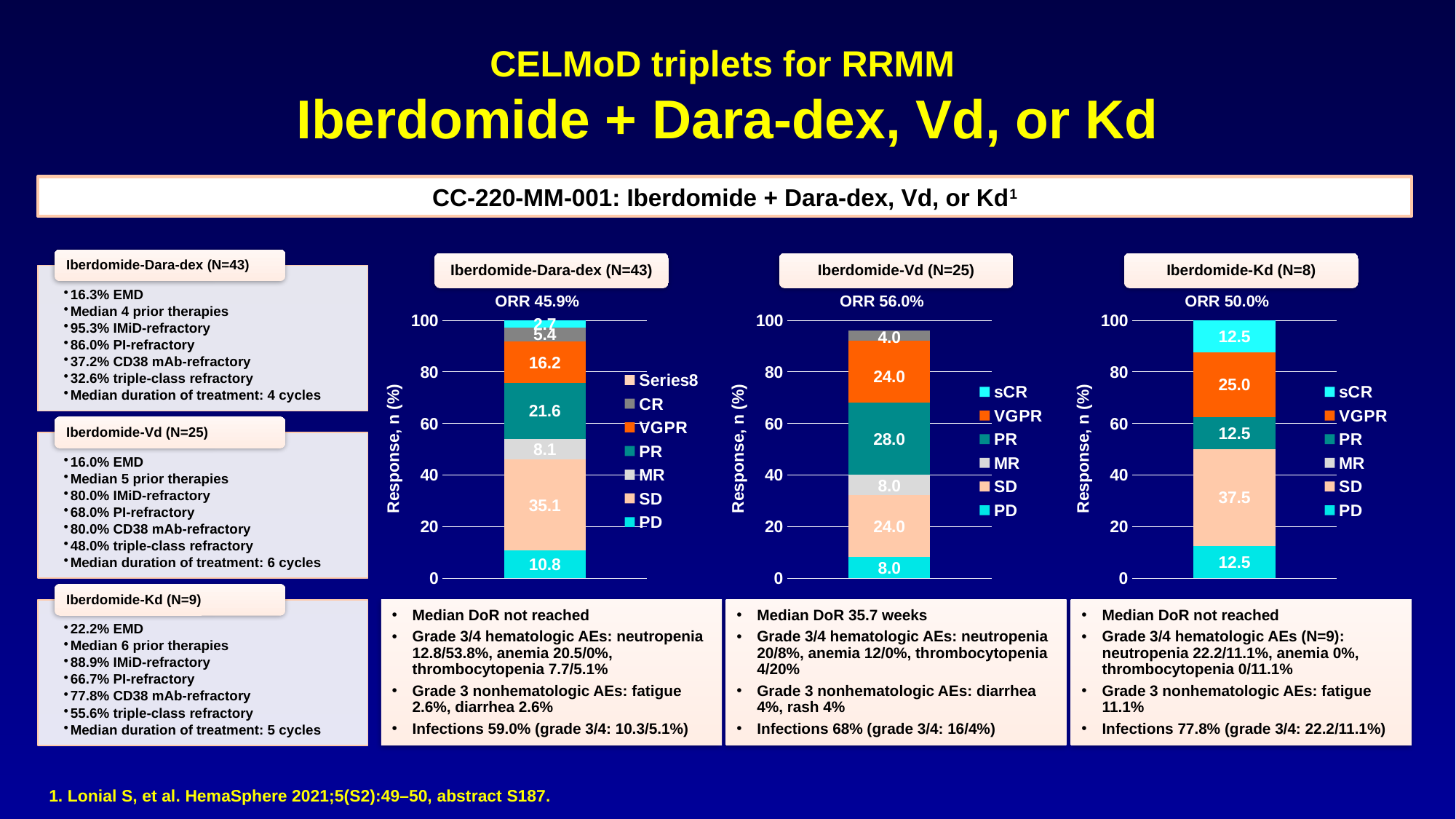
In the Iberdomide-Dara-dex (N=43) chart, what is the difference between the SD and PR segment values? 13.5 In the Iberdomide-Vd (N=25) chart, what is the value of the VGPR segment? 24.0 In the Iberdomide-Dara-dex (N=43) chart, what is the value of the PR segment? 21.6 In the Iberdomide-Kd (N=8) chart, which is larger, the VGPR segment or the PR segment? VGPR In the Iberdomide-Kd (N=8) chart, what is the value of the SD segment? 37.5 In the Iberdomide-Vd (N=25) chart, which response category has the largest segment? PR In the Iberdomide-Dara-dex (N=43) chart, what is the value of the SD segment? 35.1 How many entries does the legend of the Iberdomide-Vd (N=25) chart list? 6 How many entries does the legend of the Iberdomide-Dara-dex (N=43) chart list? 7 What ORR is shown above the Iberdomide-Vd (N=25) chart? ORR 56.0% What kind of chart is used for the Iberdomide-Kd (N=8) response data? Stacked bar chart